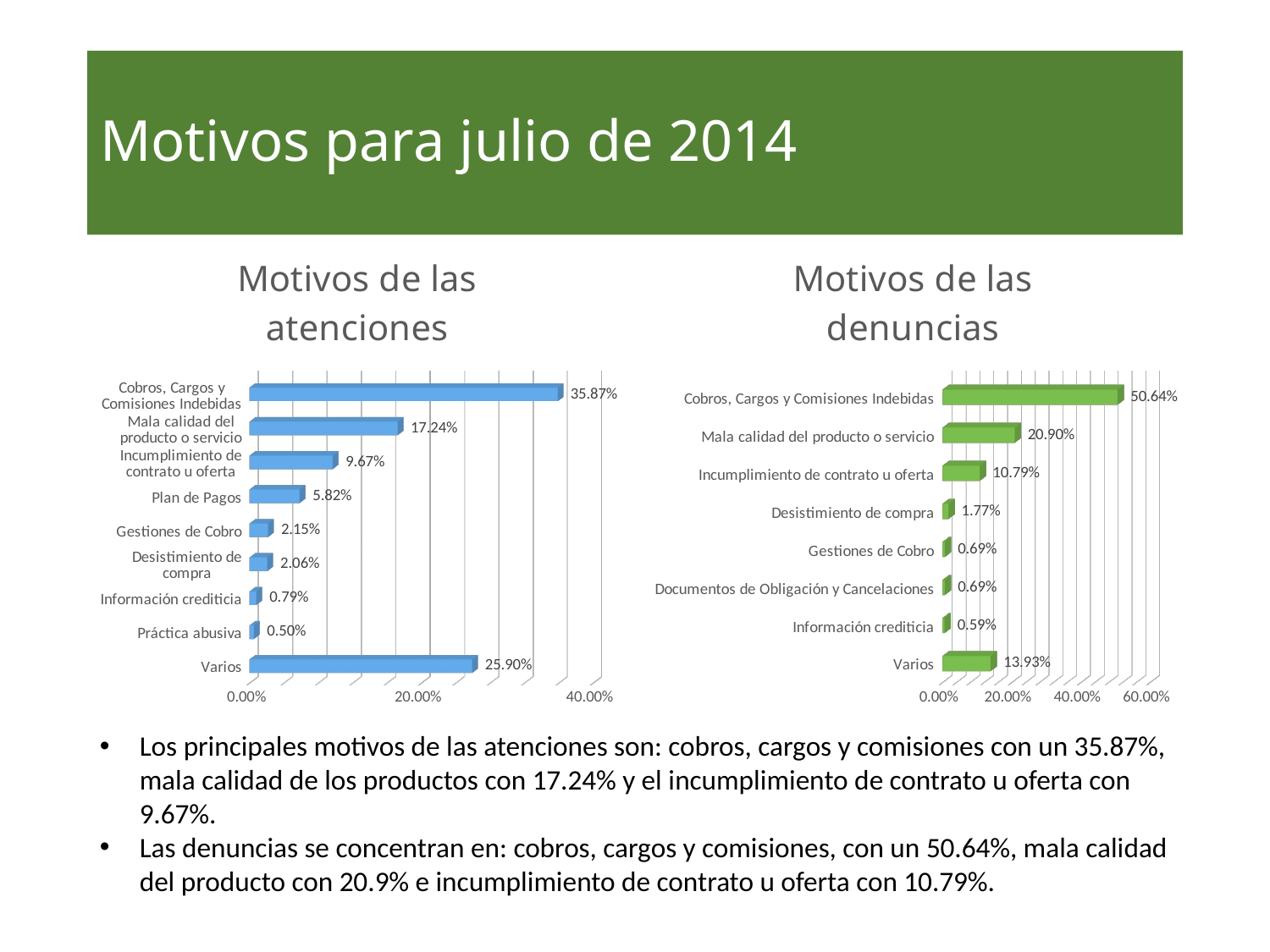
In the 'Motivos de las atenciones' chart, what is the difference between Cobros, Cargos y Comisiones Indebidas and Varios? 9.97% In the 'Motivos de las atenciones' chart, which is larger: Plan de Pagos or Gestiones de Cobro? Plan de Pagos In the 'Motivos de las denuncias' chart, what is the value for Mala calidad del producto o servicio? 20.90% How many categories are shown in the 'Motivos de las atenciones' chart? 9 What colour are the bars in the 'Motivos de las atenciones' chart? Blue In the 'Motivos de las denuncias' chart, is the value for Varios greater or less than 20.00%? less In the 'Motivos de las denuncias' chart, which category has the highest value? Cobros, Cargos y Comisiones Indebidas How many categories are shown in the 'Motivos de las denuncias' chart? 8 What type of chart is the 'Motivos de las denuncias' chart? Bar chart In the 'Motivos de las denuncias' chart, what is the difference between Incumplimiento de contrato u oferta and Desistimiento de compra? 9.02% In the 'Motivos de las atenciones' chart, which category has the lowest value? Práctica abusiva In the 'Motivos de las atenciones' chart, what is the value for Cobros, Cargos y Comisiones Indebidas? 35.87%